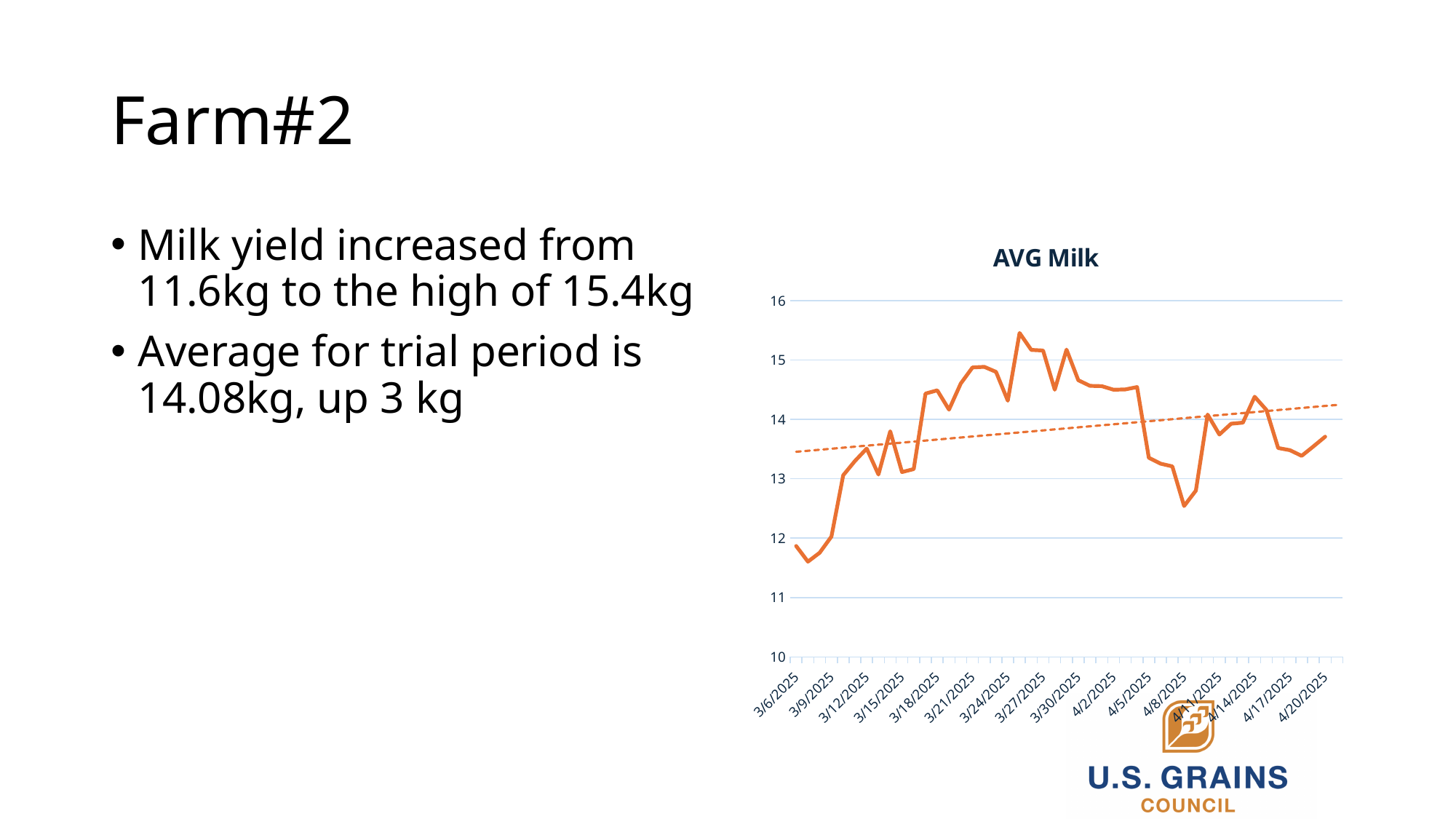
Is the lowest point on the line greater or less than 12? less Is the value for 3/6/2025 greater or less than 13? less Is the value for 3/30/2025 greater or less than 14? greater What is the title of the chart? AVG Milk What kind of chart is shown on the slide? line chart How many date labels are shown on the x axis? 16 Which is larger, the value for 3/9/2025 or the value for 3/21/2025? 3/21/2025 Does the dashed trend line rise or fall from left to right? rises